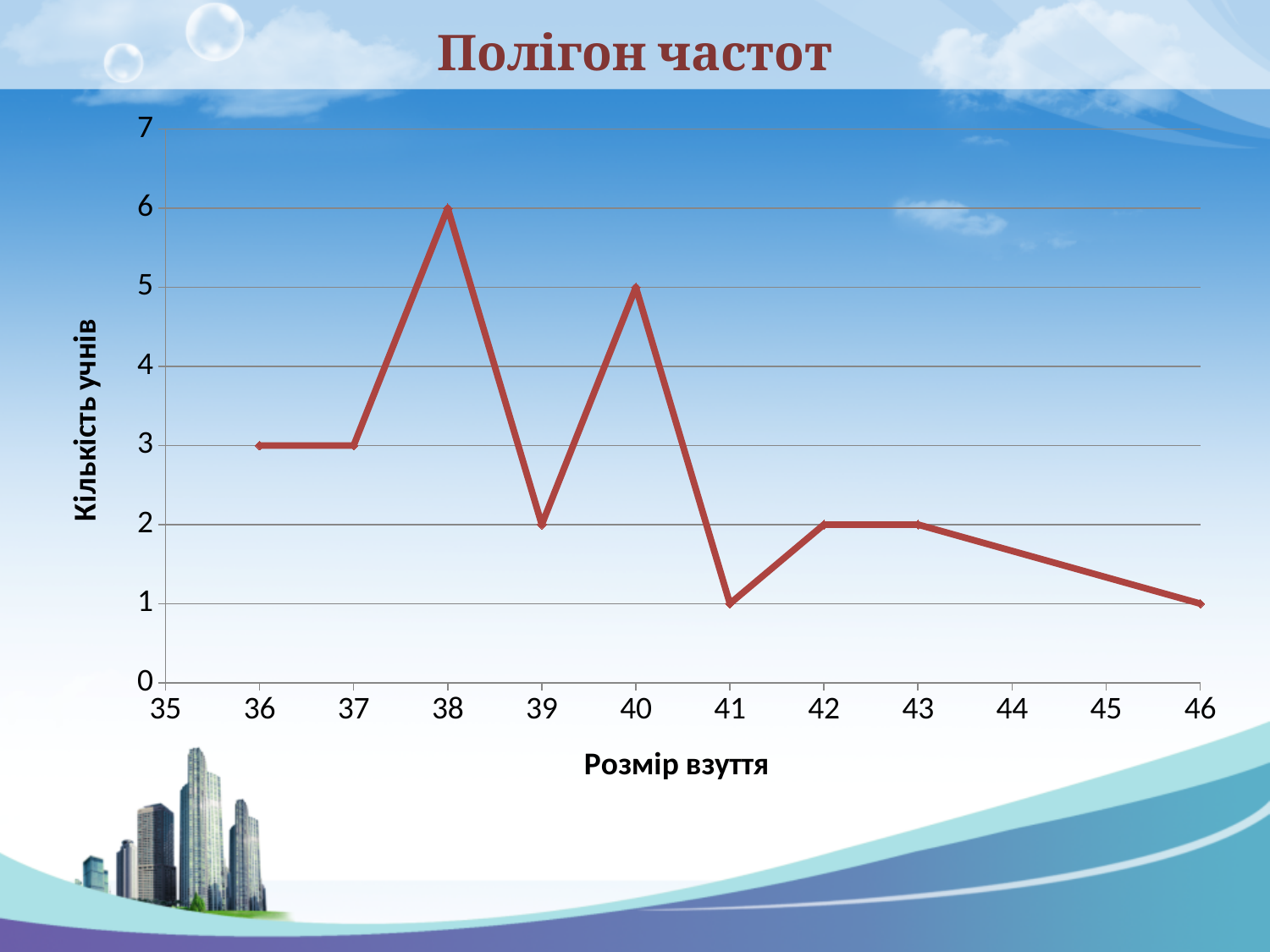
What type of chart is shown on the slide? line chart Is the number of students with shoe size 38 greater or less than 4? greater What is the label of the x axis? Розмір взуття How many students (Кількість учнів) have shoe size 38? 6 Does the number of students rise or fall from shoe size 40 to shoe size 41? fall What is the title of the chart? Полігон частот How many students have shoe size 41? 1 What is the difference between the number of students with shoe size 38 and shoe size 40? 1 How many students have shoe size 36? 3 Which has more students: shoe size 39 or shoe size 40? 40 Which shoe size has the highest number of students? 38 How many students have shoe size 40? 5